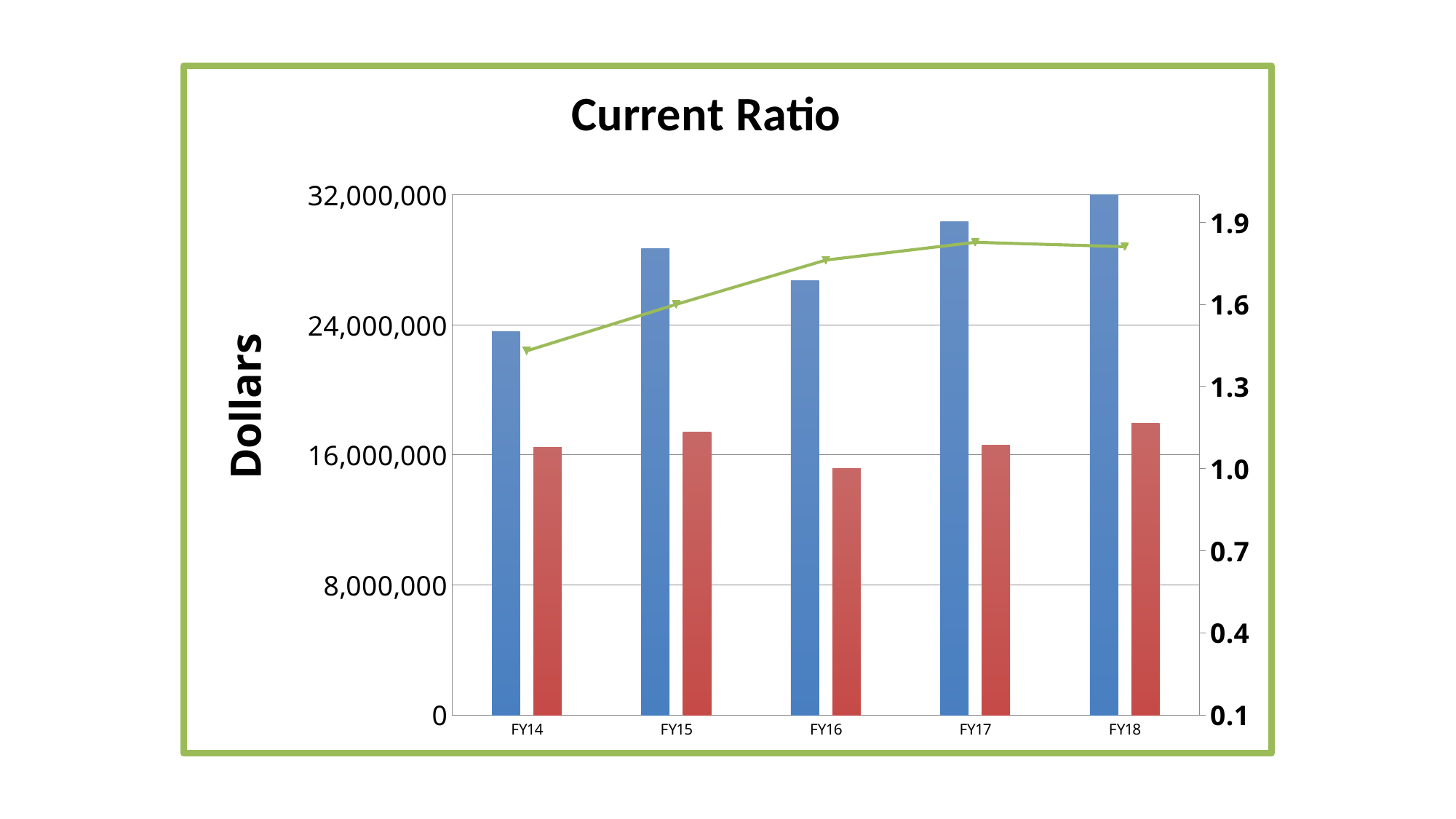
What is the label of the left vertical axis? Dollars Which fiscal year has the shortest red bar? FY16 How many fiscal years are shown on the x axis? 5 Which fiscal year has the shortest blue bar? FY14 Which fiscal year has the tallest blue bar? FY18 Which is larger, the blue bar for FY15 or the blue bar for FY16? FY15 Is the blue bar for FY16 greater or less than 24,000,000? greater Is the red bar for FY16 greater or less than 16,000,000? less Which fiscal year has the tallest red bar? FY18 What is the title of the chart? Current Ratio Is the green line value for FY14 greater or less than 1.6 on the right axis? less What kind of chart is shown on the slide? Combination bar and line chart